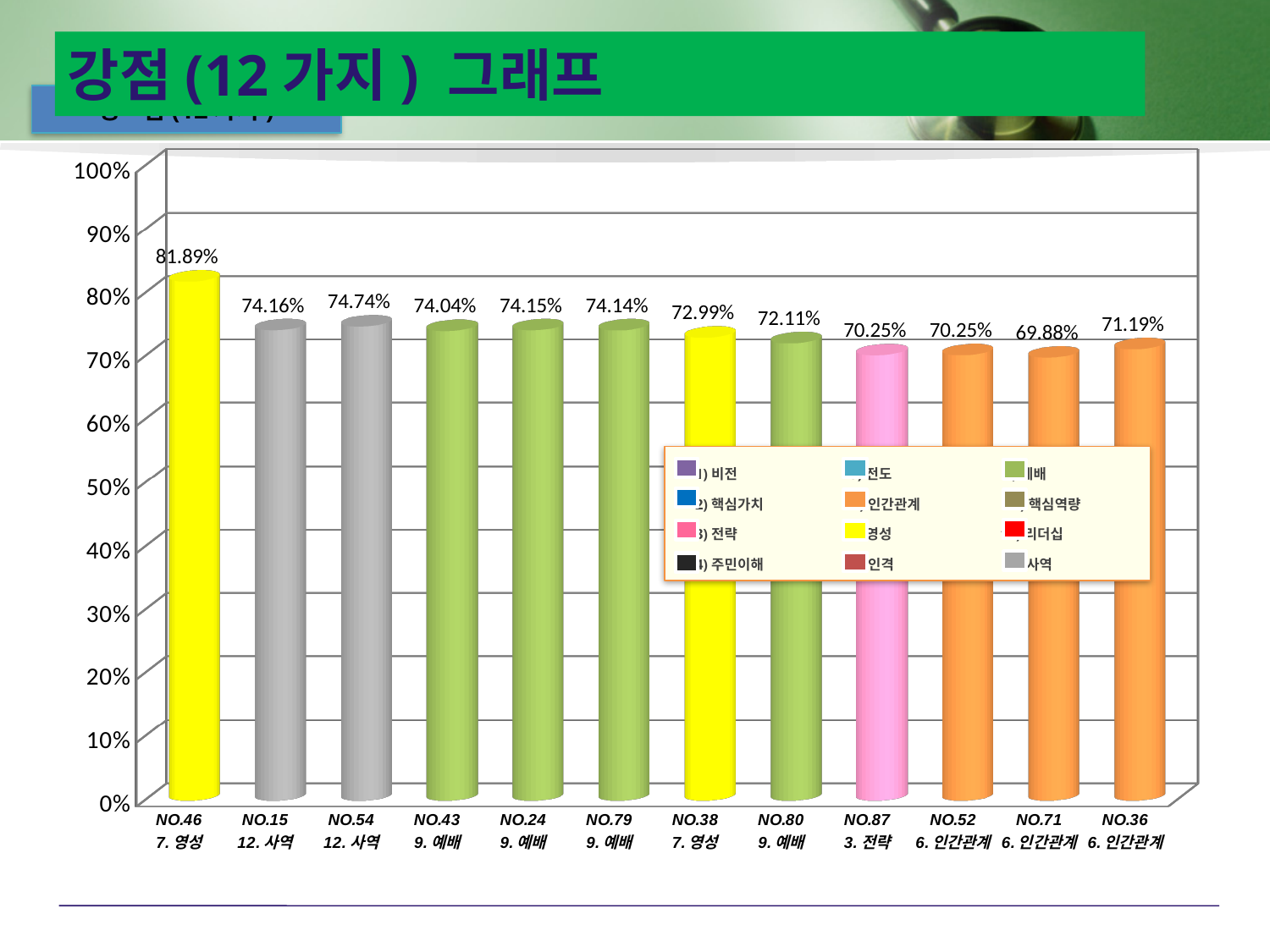
What kind of chart is shown on the slide? Bar chart What is the title of the slide? 강점 (12 가지) 그래프 What is the value for NO.54 (12. 사역)? 74.74% What is the difference between the values for NO.38 and NO.80? 0.88% Which is larger, the value for NO.46 or the value for NO.38? NO.46 What is the value for NO.46 (7. 영성)? 81.89% Which category has the lowest value? NO.71 (6. 인간관계) Which category has the highest value? NO.46 (7. 영성) What is the value for NO.87 (3. 전략)? 70.25% What is the difference between the values for NO.46 and NO.15? 7.73% How many bars are plotted in the chart? 12 What is the value for NO.36 (6. 인간관계)? 71.19%